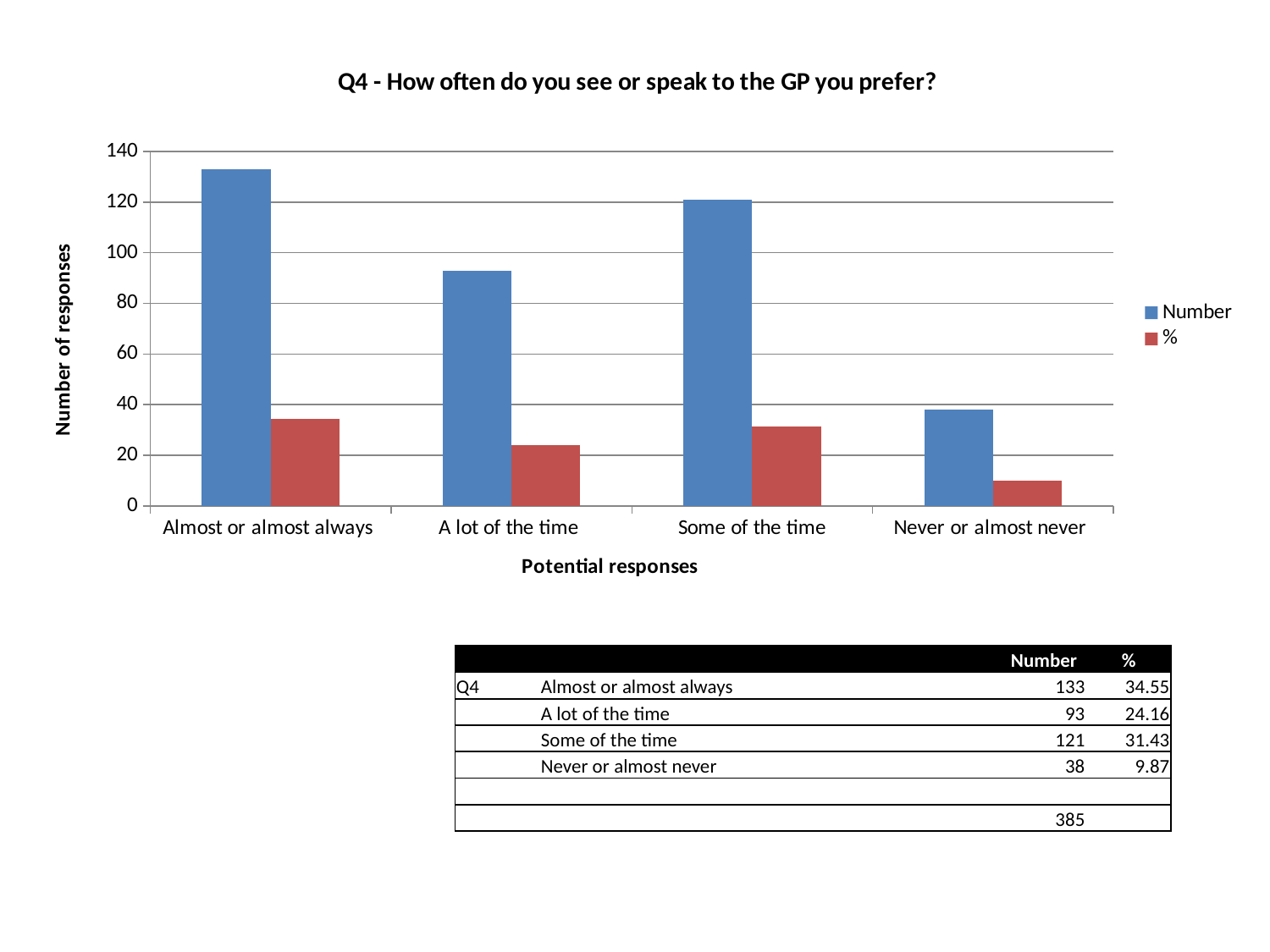
What type of chart is shown on the slide? bar chart Is the Number value for 'Never or almost never' greater or less than 40? less What is the Number value for 'Some of the time'? 121 Which response category has the lowest Number value? Never or almost never What is the title of the chart? Q4 - How often do you see or speak to the GP you prefer? Which is larger, the Number value for 'A lot of the time' or for 'Some of the time'? Some of the time How many response categories are shown on the x axis of the chart? 4 What is the label on the y axis of the chart? Number of responses How many series does the chart legend list? 2 Which response category has the highest Number value? Almost or almost always What is the difference between the Number values for 'Almost or almost always' and 'Never or almost never'? 95 What is the % value for 'A lot of the time'? 24.16